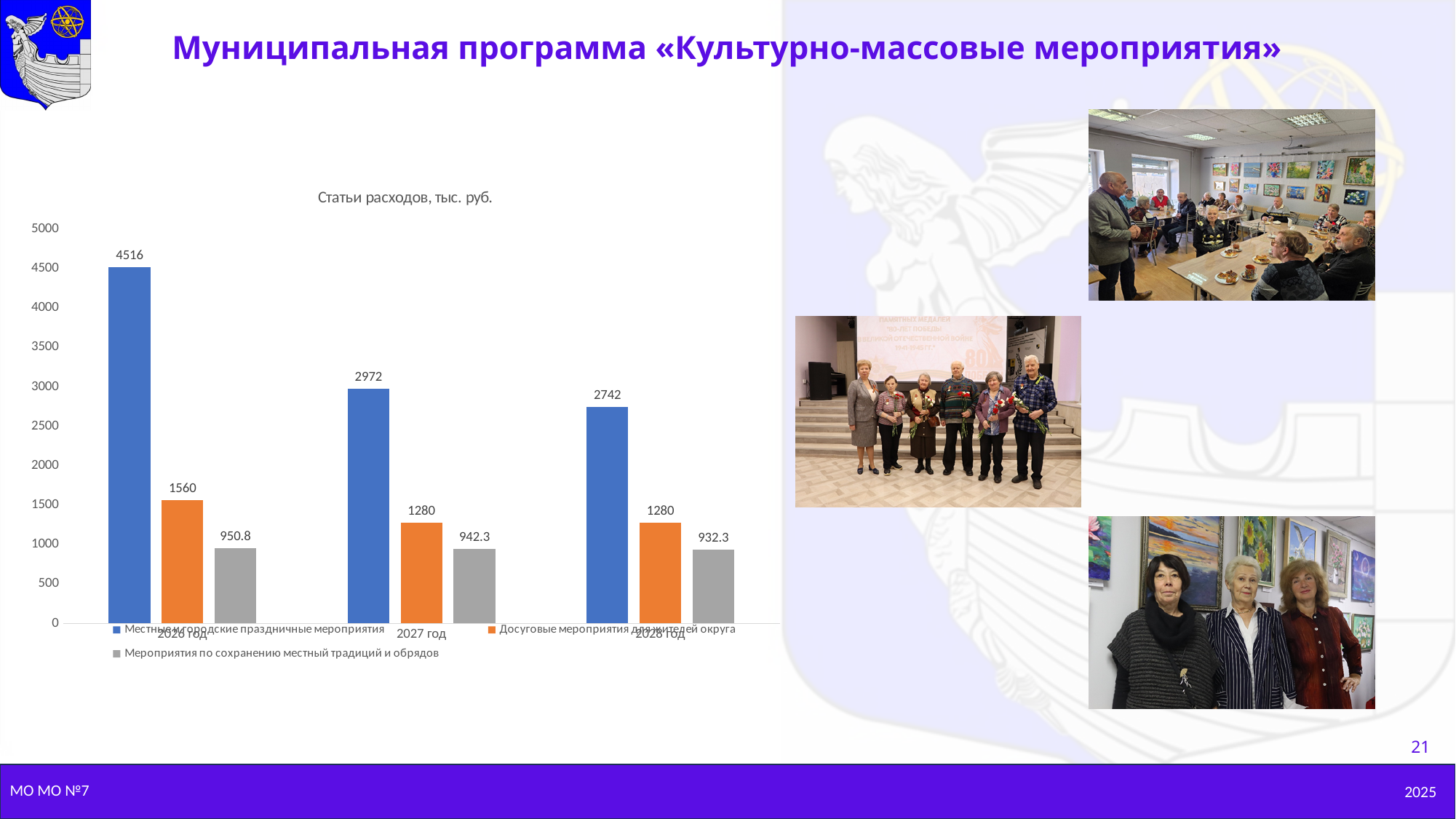
What is the value for «Местные и городские праздничные мероприятия» in 2026 год? 4516 In which year is the value for «Местные и городские праздничные мероприятия» highest? 2026 год What is the title of the chart? Статьи расходов, тыс. руб. In which year is the value for «Мероприятия по сохранению местный традиций и обрядов» lowest? 2028 год How many series does the legend list? 3 What is the difference between the values for «Местные и городские праздничные мероприятия» in 2026 год and 2027 год? 1544 What kind of chart is shown on the slide? Bar chart What is the value for «Мероприятия по сохранению местный традиций и обрядов» in 2028 год? 932.3 Do the values for «Местные и городские праздничные мероприятия» rise or fall from 2026 год to 2028 год? Fall What is the value for «Досуговые мероприятия для жителей округа» in 2027 год? 1280 How many years are shown on the x axis? 3 Which is larger: «Досуговые мероприятия для жителей округа» in 2026 год or in 2028 год? 2026 год